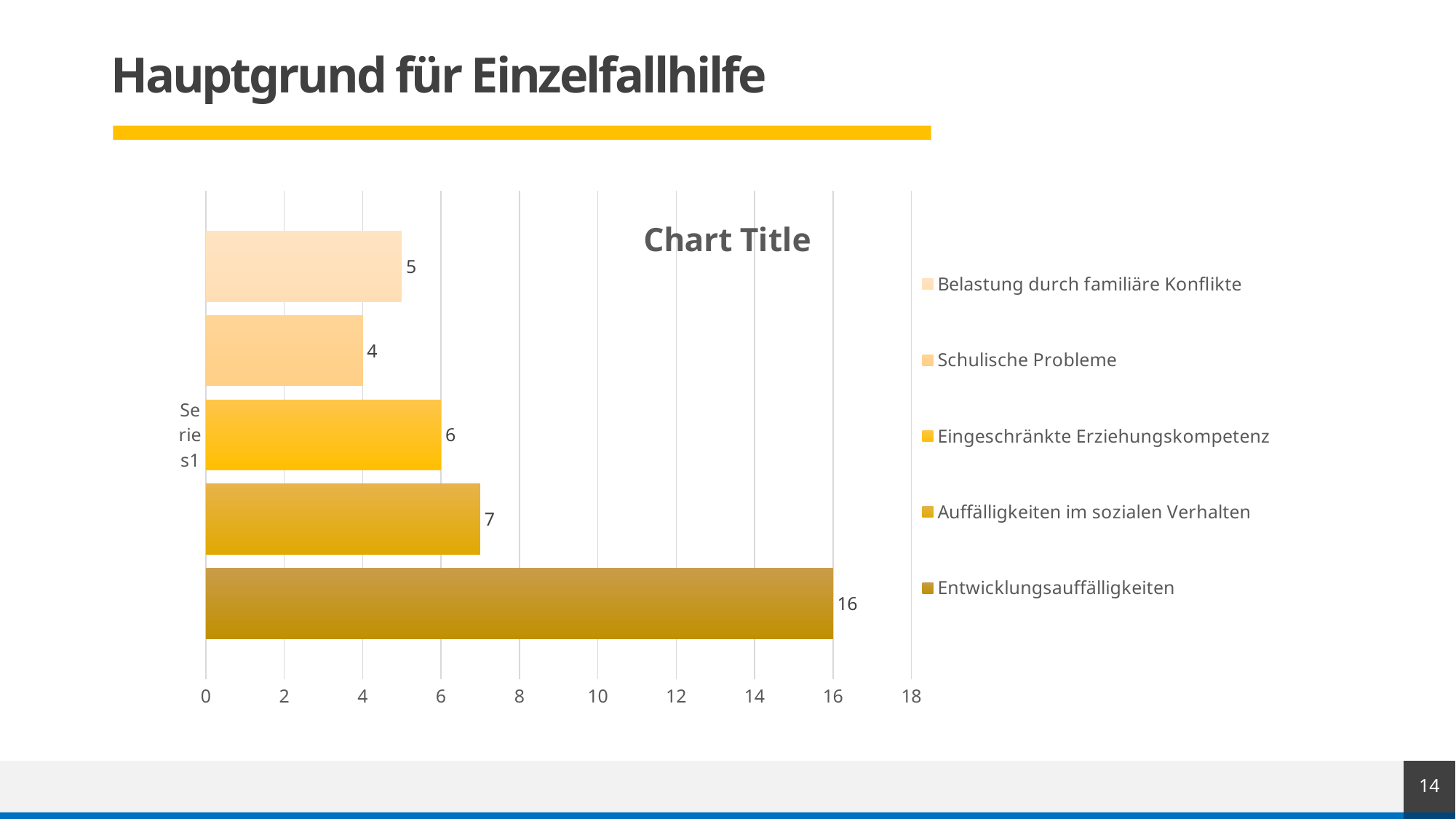
What is the value for Entwicklungsauffälligkeiten? 16 What is the value for Eingeschränkte Erziehungskompetenz? 6 Which is larger, the value for Auffälligkeiten im sozialen Verhalten or the value for Eingeschränkte Erziehungskompetenz? Auffälligkeiten im sozialen Verhalten Which legend entry has the lowest value? Schulische Probleme What is the value for Schulische Probleme? 4 Which legend entry has the highest value? Entwicklungsauffälligkeiten How many series does the legend list? 5 What is the difference between the values for Entwicklungsauffälligkeiten and Auffälligkeiten im sozialen Verhalten? 9 What is the value for Belastung durch familiäre Konflikte? 5 What is the title shown inside the chart area? Chart Title What kind of chart is shown on the slide? bar chart Is the value for Entwicklungsauffälligkeiten greater or less than 10? greater